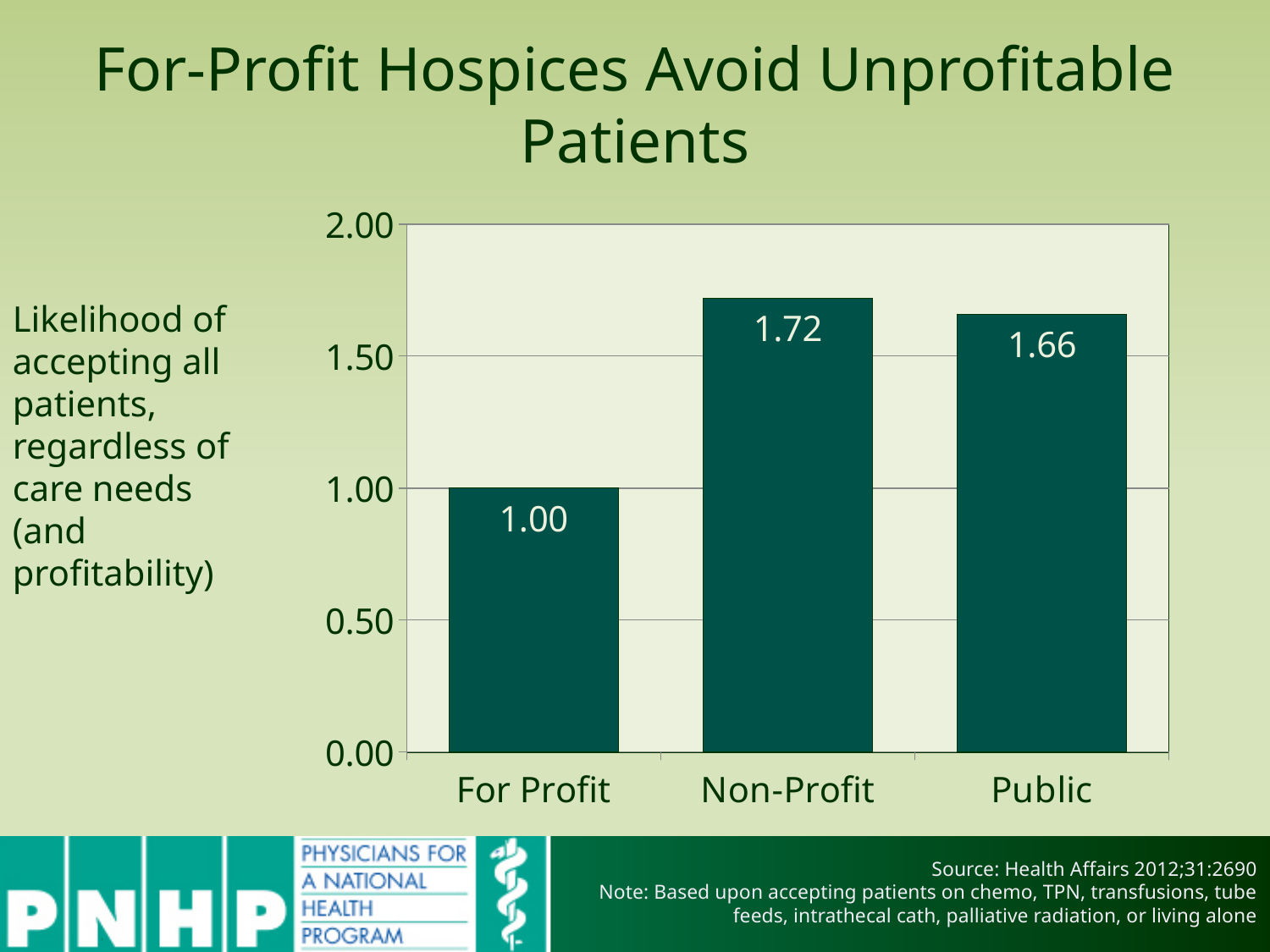
What is the title of the slide containing the chart? For-Profit Hospices Avoid Unprofitable Patients Which is larger, the value for Public or the value for For Profit? Public Which category has the highest value? Non-Profit Is the value for Public greater or less than 1.50? greater What is the difference between the Non-Profit and For Profit values? 0.72 What is the difference between the Non-Profit and Public values? 0.06 What is the value for Non-Profit? 1.72 What is the value for For Profit? 1.00 Which category has the lowest value? For Profit How many categories are shown on the x axis? 3 What kind of chart is shown on the slide? bar chart What is the value for Public? 1.66